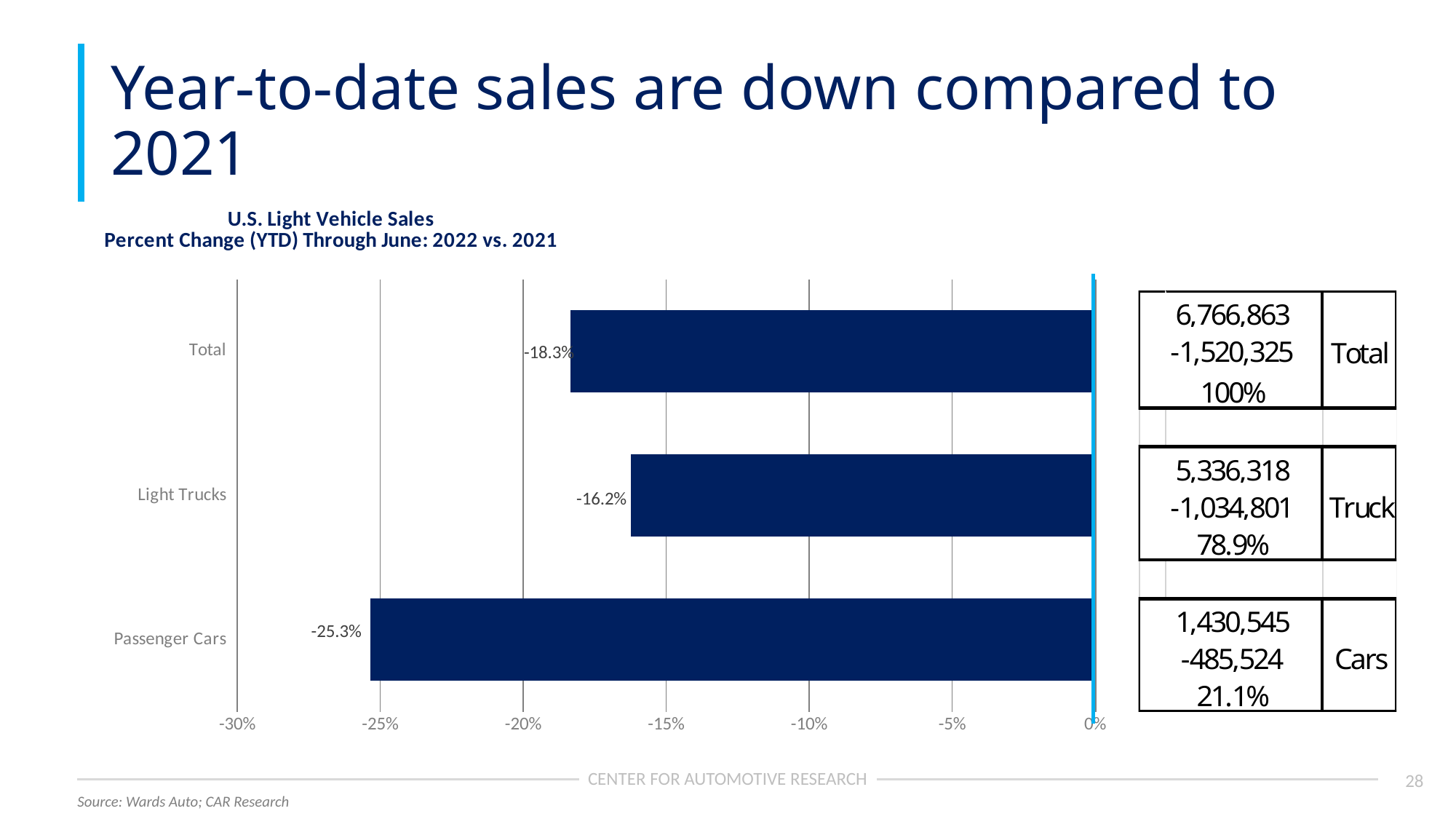
What is the percent change for Total? -18.3% What kind of chart is shown on the slide? Bar chart Which category shows the largest decline? Passenger Cars What is the percent change for Light Trucks? -16.2% What is the difference in percentage points between the Passenger Cars and Light Trucks percent changes? 9.1 percentage points What is the lowest value shown on the x axis? -30% What is the title of the chart? U.S. Light Vehicle Sales Percent Change (YTD) Through June: 2022 vs. 2021 Which category shows the smallest decline? Light Trucks Is the value for Light Trucks greater or less than -20%? greater What is the percent change for Passenger Cars? -25.3% Which declined more, Passenger Cars or Total? Passenger Cars How many categories are shown in the chart? 3